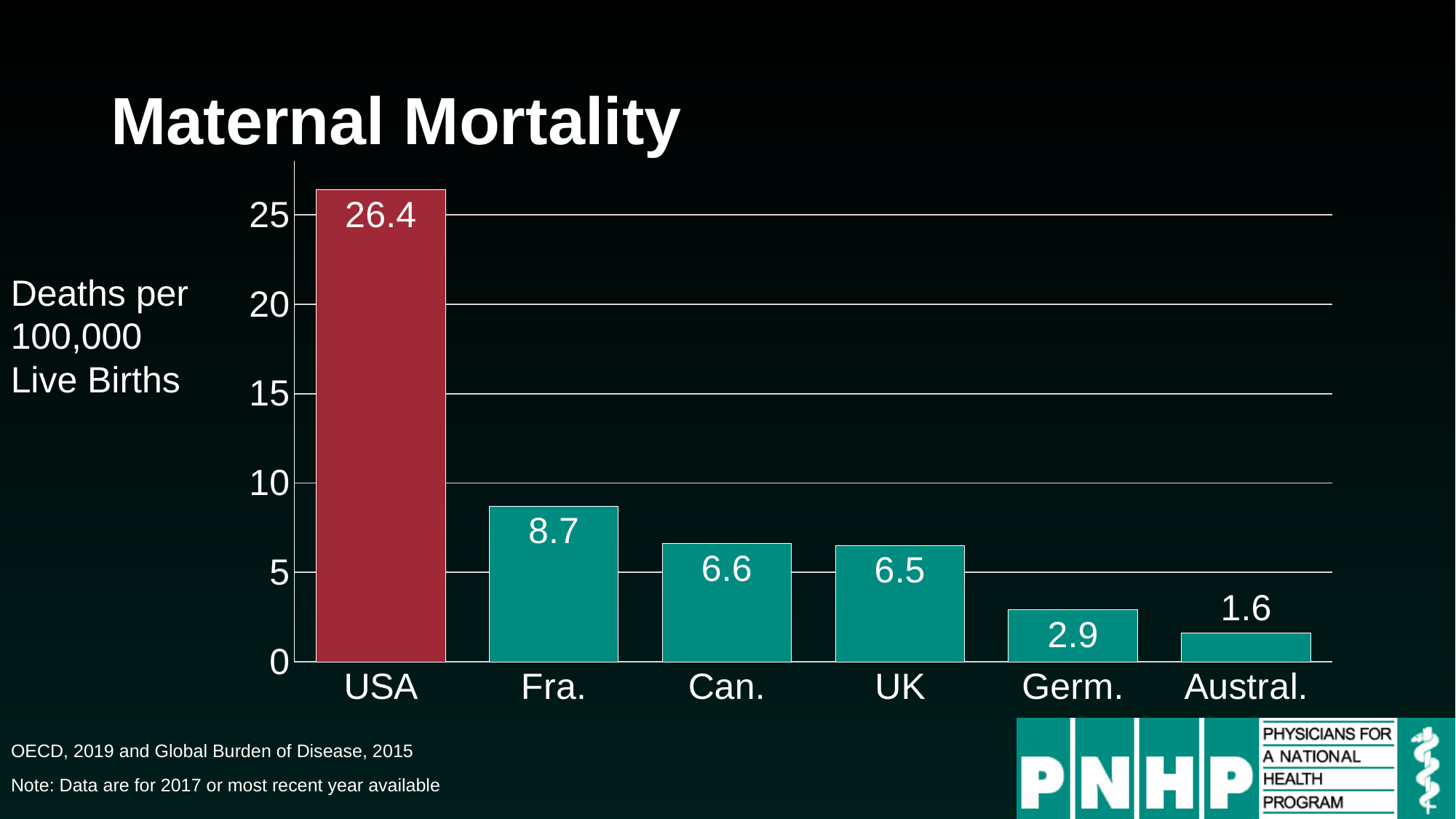
What kind of chart is shown on the slide? bar chart What is the difference between the Can. value and the Austral. value? 5.0 Which country has the lowest maternal mortality on the chart? Austral. Is the value for the USA greater or less than 25? greater Which country has the highest maternal mortality on the chart? USA What is the value shown for Fra.? 8.7 How many countries are shown on the chart? 6 Which is larger, the value for Fra. or the value for Germ.? Fra. What is the value shown for Germ.? 2.9 What is the title of the chart? Maternal Mortality What is the difference between the USA value and the Fra. value? 17.7 What is the maternal mortality value for the USA? 26.4